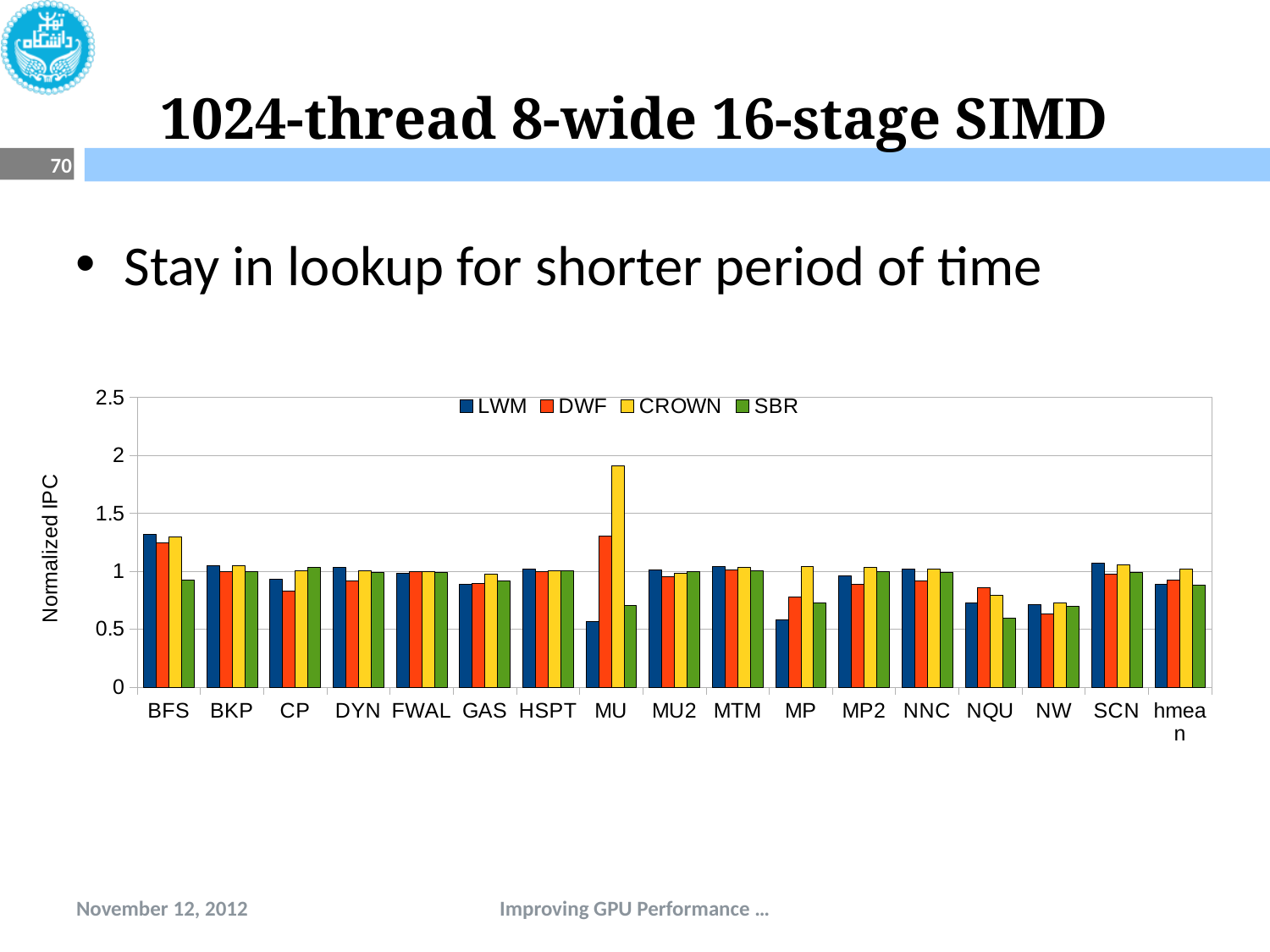
What is the label of the y axis? Normalized IPC For BFS, which is larger: the LWM value or the SBR value? LWM How many categories are shown along the x axis? 17 Is the LWM value for BFS greater or less than 1? greater Which series has the tallest bar for MU? CROWN Is the SBR value for NQU greater or less than 1? less Is the CROWN value for MU greater or less than 1.5? greater What kind of chart is shown on the slide? bar chart Which series is drawn in yellow? CROWN For which category does CROWN reach its highest value? MU How many series does the legend list? 4